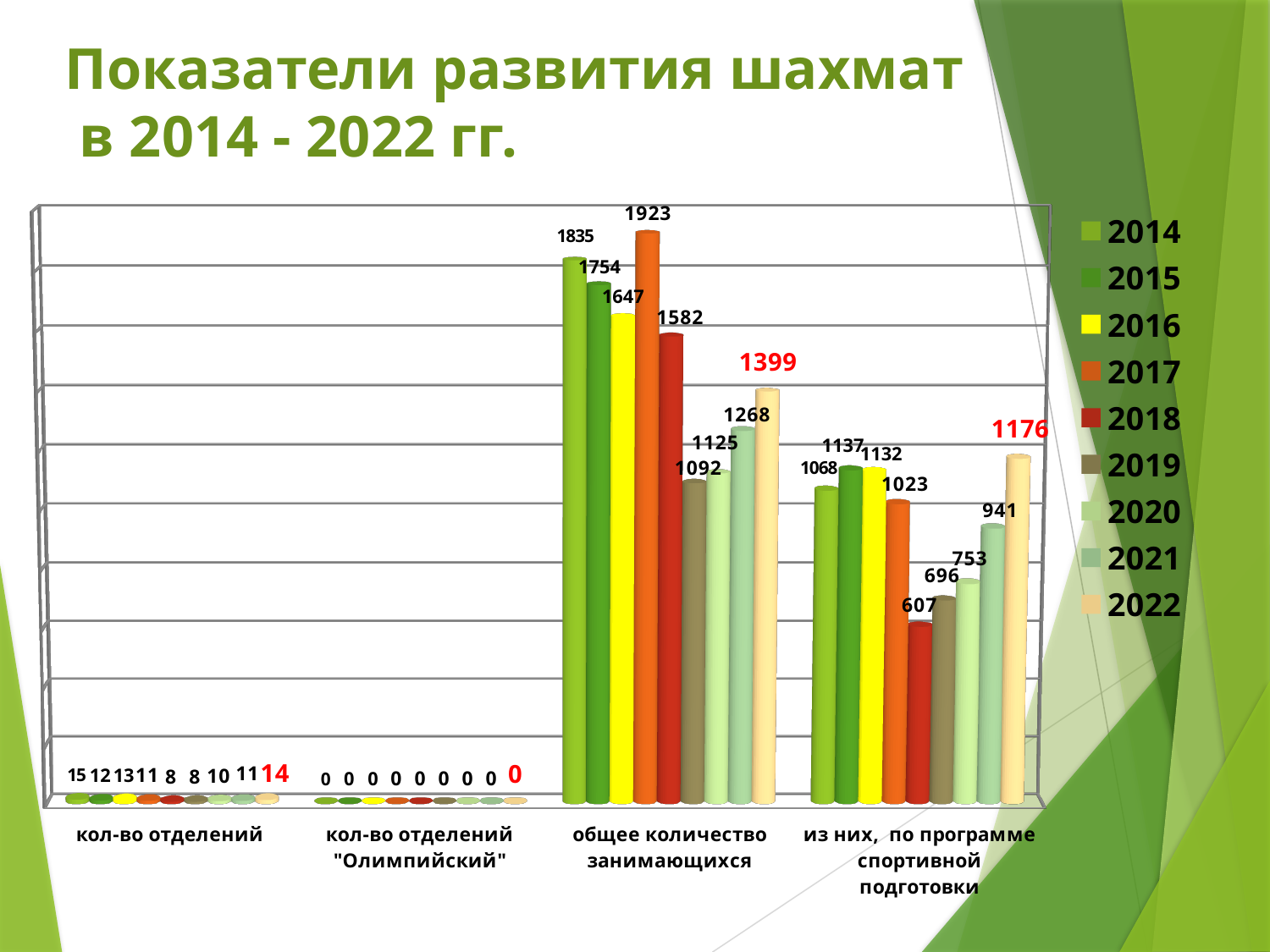
Which year has the lowest value in the category "из них, по программе спортивной подготовки"? 2018 How many categories are shown on the x axis? 4 What is the value for every year in the category "кол-во отделений "Олимпийский""? 0 What is the value for 2014 in the category "кол-во отделений"? 15 What is the value for 2022 in the category "из них, по программе спортивной подготовки"? 1176 Which year has the highest value in the category "общее количество занимающихся"? 2017 What is the value for 2017 in the category "общее количество занимающихся"? 1923 What is the difference between the 2017 and 2018 values in the category "общее количество занимающихся"? 341 What type of chart is shown on the slide? bar chart In the category "из них, по программе спортивной подготовки", which is larger: the value for 2015 or the value for 2016? 2015 How many series does the legend list? 9 What is the value for 2018 in the category "из них, по программе спортивной подготовки"? 607